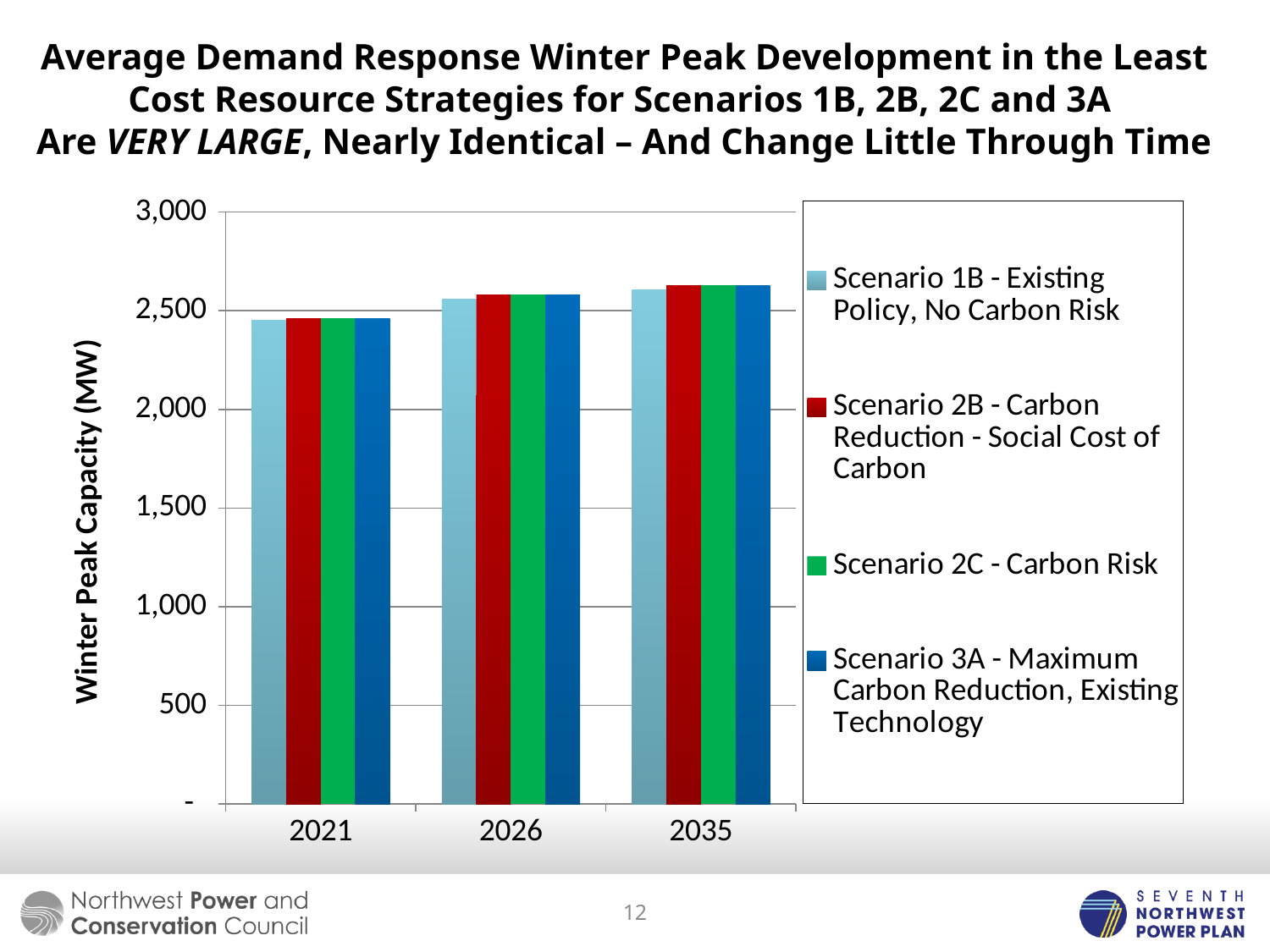
How many years are shown on the x axis of the chart? 3 Is the value for Scenario 2C in 2021 greater or less than 1,500? greater Do the values for Scenario 1B rise or fall from 2021 to 2035? rise Is the value for Scenario 1B in 2021 greater or less than 2,000? greater Which year has the lowest values across all scenarios? 2021 What kind of chart is shown on the slide? bar chart Which year has the highest values across all scenarios? 2035 What is the label on the vertical axis of the chart? Winter Peak Capacity (MW) Is the value for Scenario 2B in 2035 greater or less than 2,500? greater Which scenario is shown in green in the legend? Scenario 2C - Carbon Risk How many series does the chart's legend list? 4